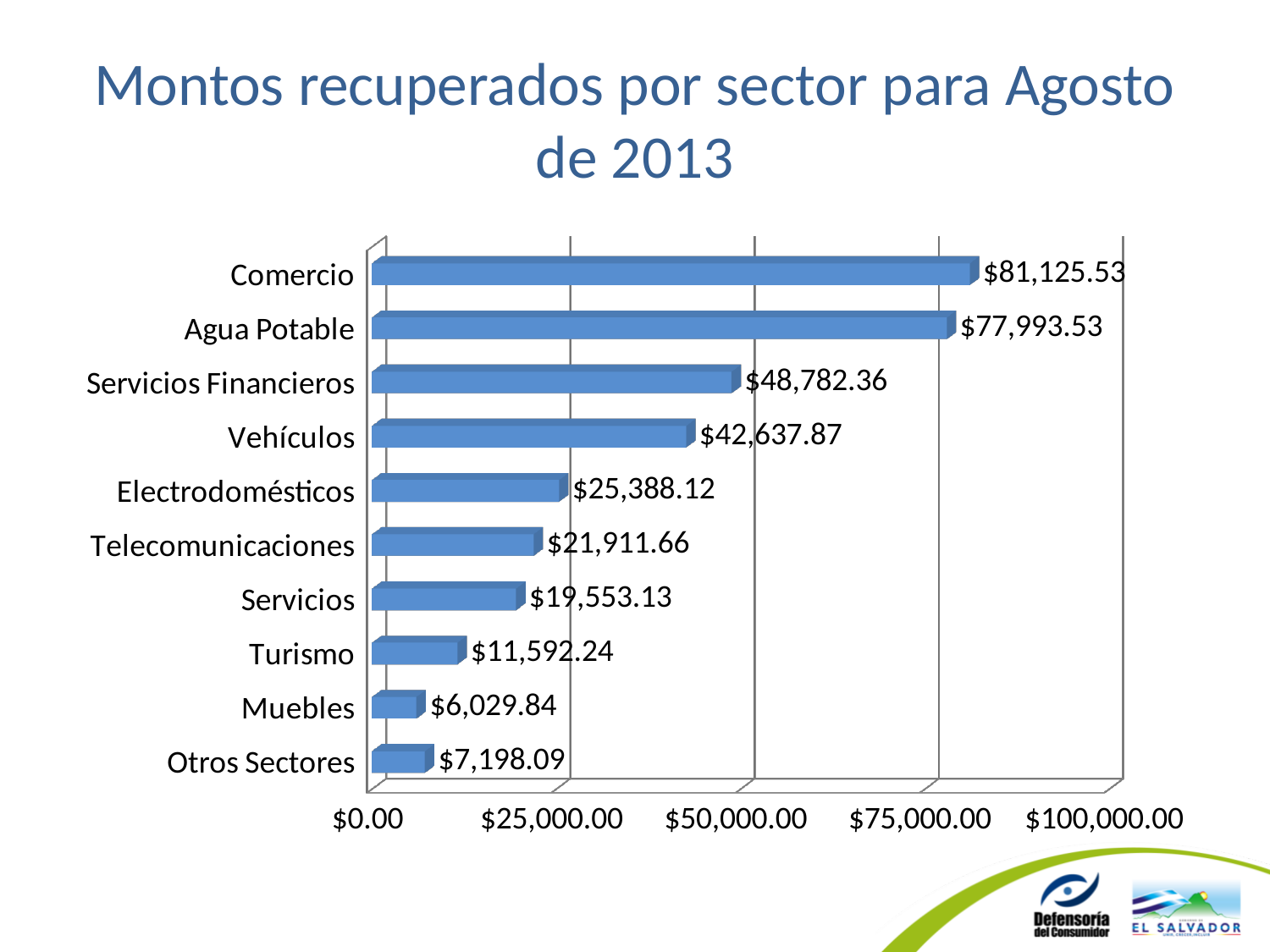
Which sector has the lowest recovered amount? Muebles What is the value for Telecomunicaciones? $21,911.66 What is the difference between the values for Servicios Financieros and Vehículos? $6,144.49 What is the difference between the values for Comercio and Agua Potable? $3,132.00 What kind of chart is shown on the slide? Bar chart Which sector has the highest recovered amount? Comercio Is the value for Vehículos greater or less than $50,000.00? less What is the title of the chart? Montos recuperados por sector para Agosto de 2013 Which is larger, the value for Otros Sectores or the value for Muebles? Otros Sectores How many sectors are shown in the chart? 10 What is the value for Comercio? $81,125.53 What is the value for Muebles? $6,029.84